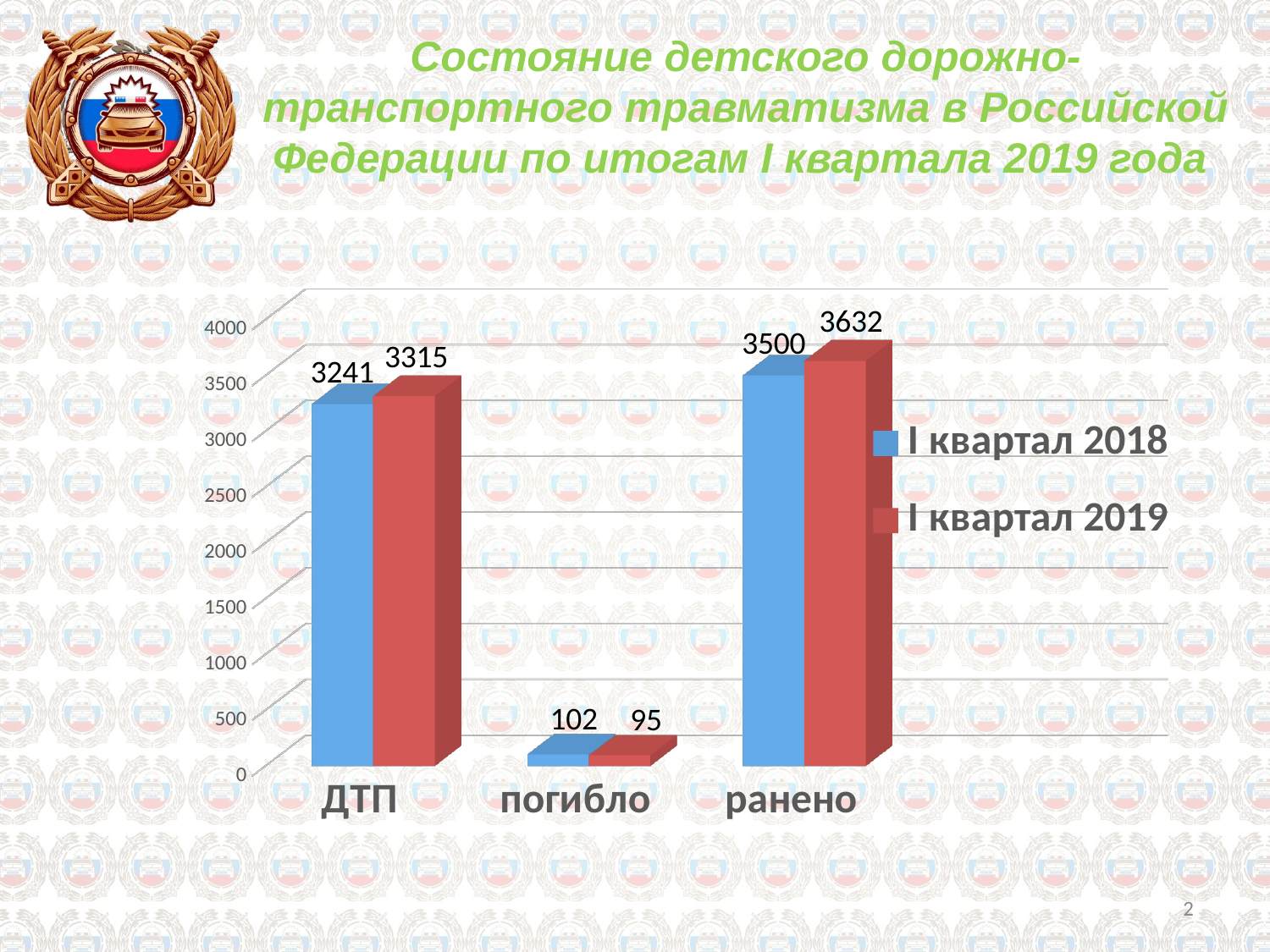
Which category has the highest value in I квартал 2019? ранено What is the value for ранено in I квартал 2019? 3632 What is the value for ДТП in I квартал 2018? 3241 How many categories are shown on the x axis? 3 How many series does the legend list? 2 What is the value for погибло in I квартал 2019? 95 What is the difference between the ранено values for I квартал 2019 and I квартал 2018? 132 What is the value for погибло in I квартал 2018? 102 Which category has the lowest value in I квартал 2018? погибло What kind of chart is shown on the slide? bar chart Which is larger for погибло: I квартал 2018 or I квартал 2019? I квартал 2018 What is the value for ДТП in I квартал 2019? 3315